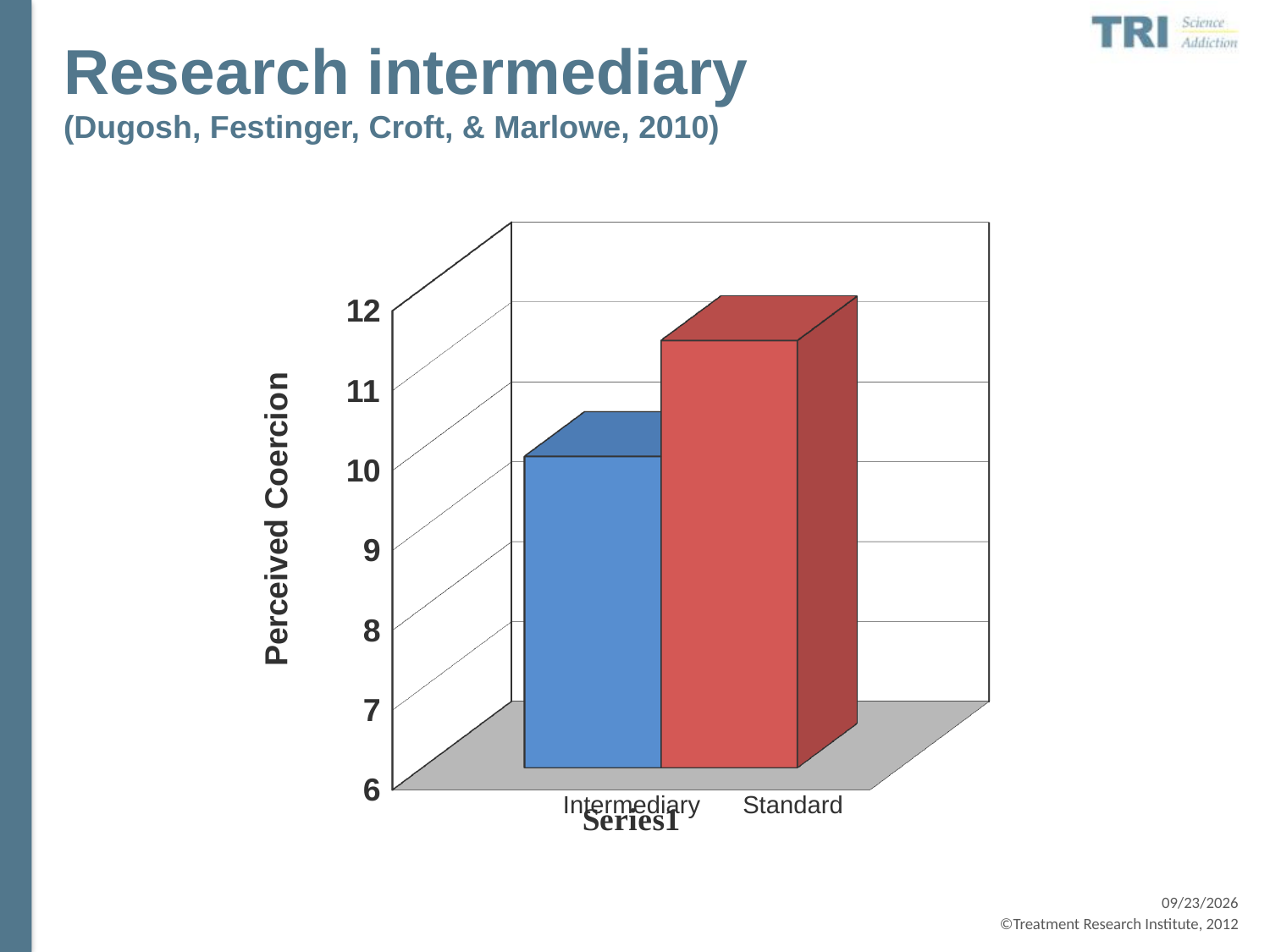
Which category has the lower Perceived Coercion value? Intermediary How many bars are plotted in the chart? 2 Is the value for Intermediary larger or smaller than the value for Standard? smaller Which category has the higher Perceived Coercion value? Standard What is the label on the vertical axis of the chart? Perceived Coercion What kind of chart is shown on the slide? bar chart Do the values rise or fall going from Intermediary to Standard along the x axis? rise Is the value for Intermediary greater or less than 11? less What colour is the bar for Standard? red Is the value for Standard greater or less than 10? greater Is the value for Intermediary greater or less than 9? greater